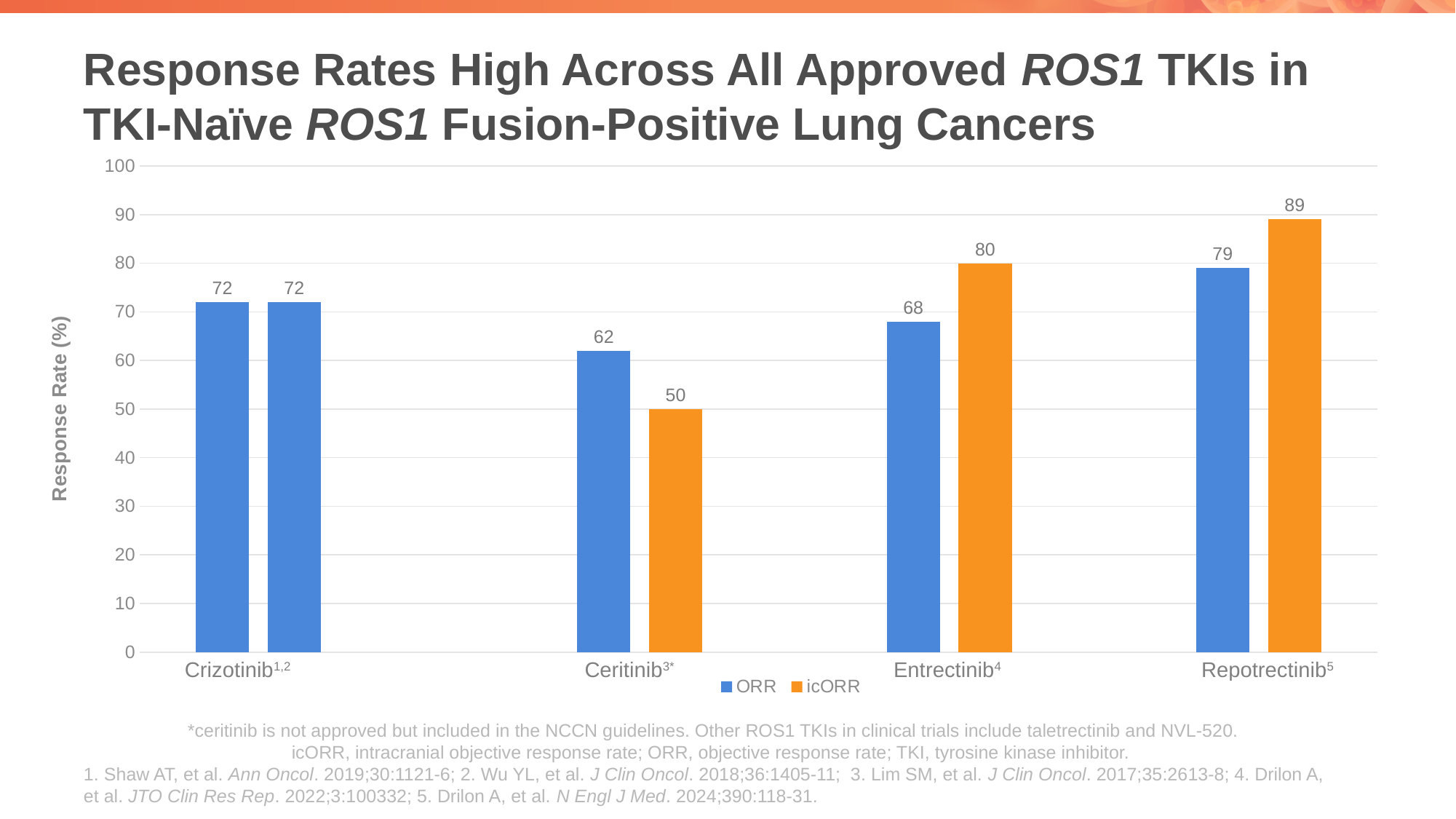
What is the icORR value for Repotrectinib? 89 What kind of chart is shown on the slide? Bar chart What is the difference between the icORR and ORR for Entrectinib? 12 Which drug has the highest icORR? Repotrectinib Which drug has the lowest ORR? Ceritinib Is the ORR value for Repotrectinib greater or less than 70? greater What is the icORR value for Ceritinib? 50 How many drugs are shown on the x axis? 4 What is the label of the y axis? Response Rate (%) How many series does the legend list? 2 What is the ORR value for Entrectinib? 68 Which is larger for Ceritinib, the ORR or the icORR? ORR